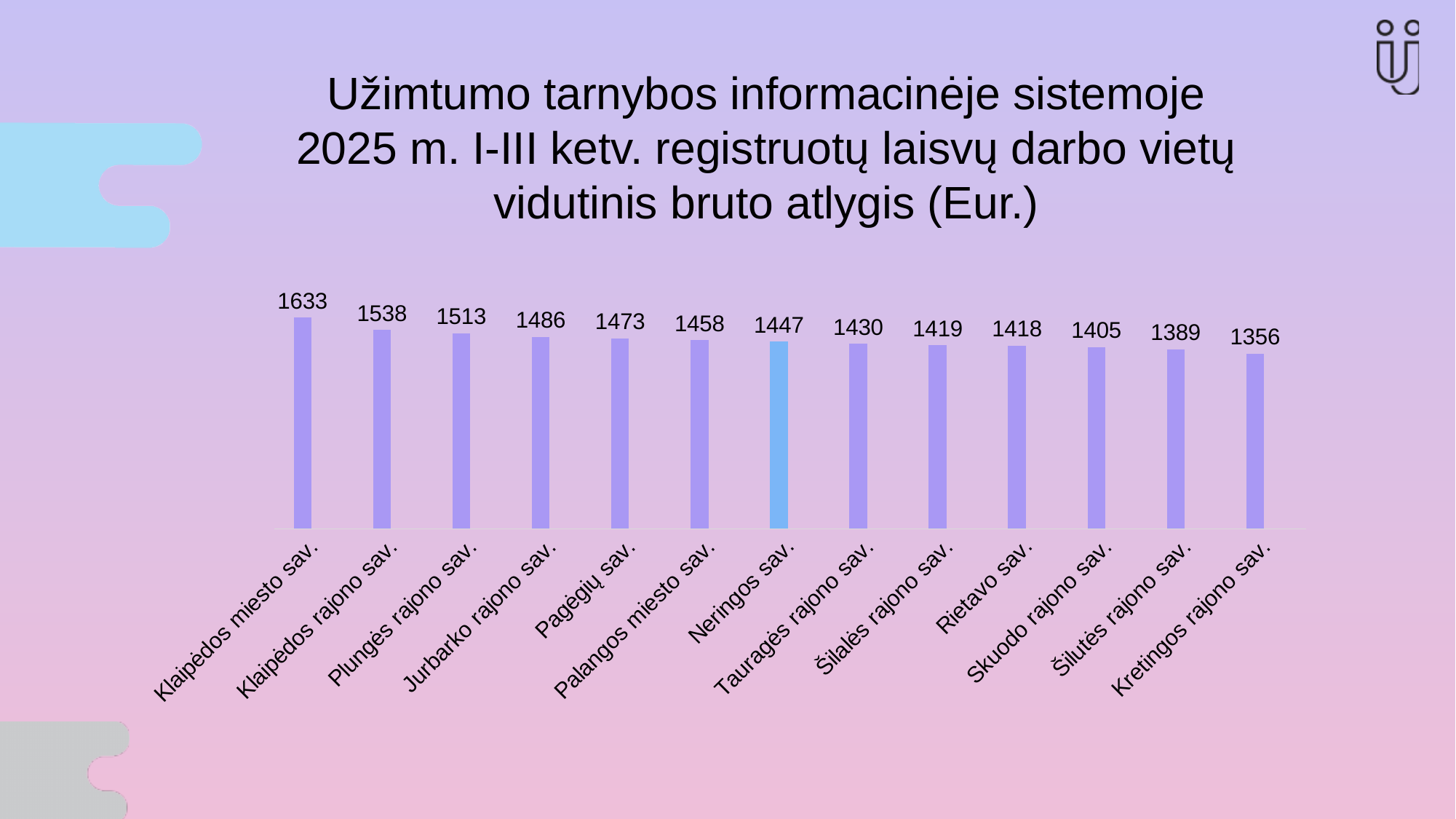
What is the difference between the values for Klaipėdos miesto sav. and Kretingos rajono sav.? 277 What is the value for Neringos sav.? 1447 Do the values rise or fall from left to right along the x axis? fall Which category has the highest value? Klaipėdos miesto sav. Which is larger, the value for Pagėgių sav. or the value for Palangos miesto sav.? Pagėgių sav. What kind of chart is shown on the slide? bar chart What is the value for Klaipėdos miesto sav.? 1633 Which category has the lowest value? Kretingos rajono sav. Which bar is shown in a different colour from the others? Neringos sav. How many categories are shown in the chart? 13 What is the difference between the values for Klaipėdos rajono sav. and Plungės rajono sav.? 25 What is the value for Rietavo sav.? 1418